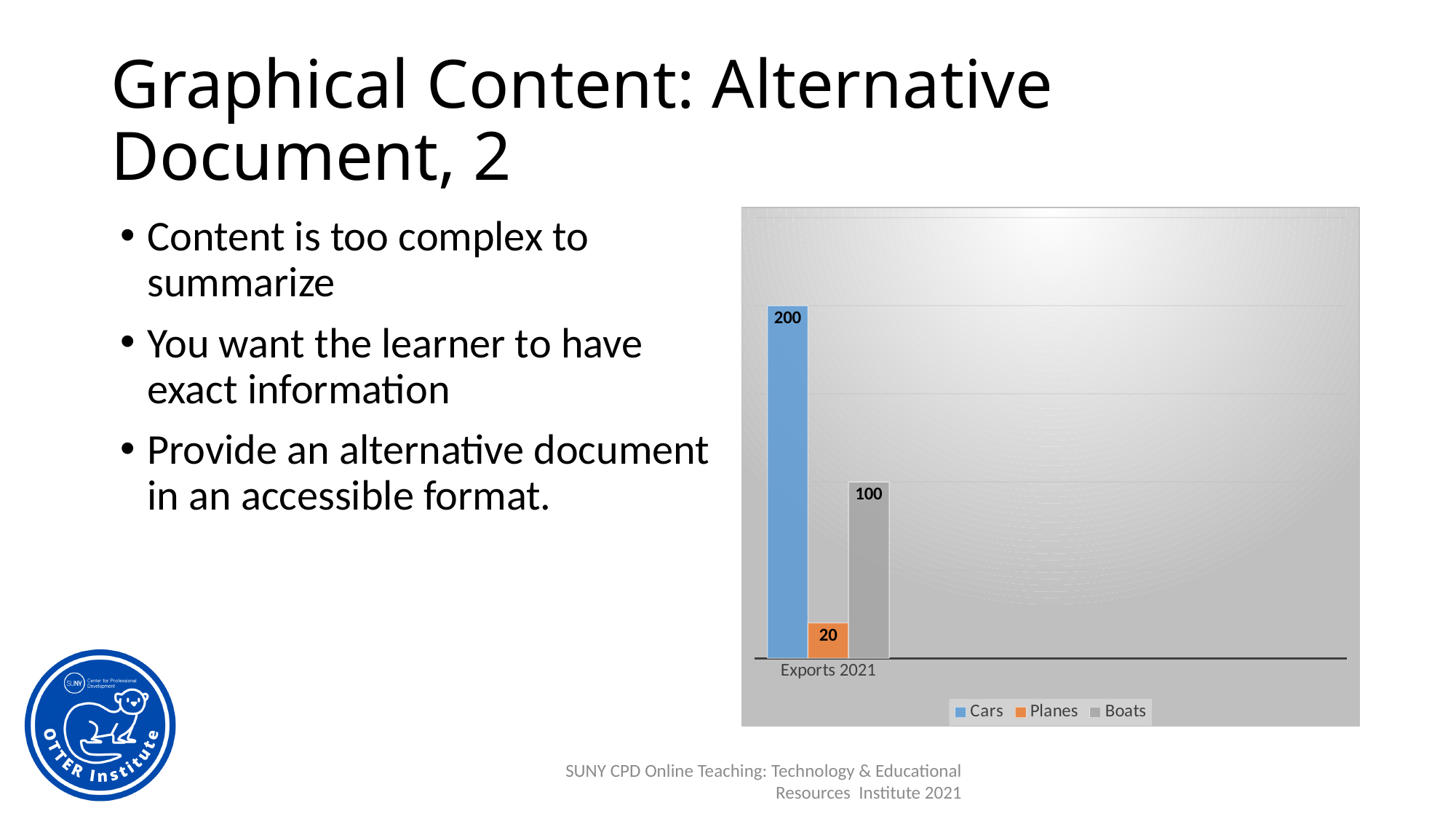
Which series has the lowest value in Exports 2021? Planes What kind of chart is shown on the slide? Bar chart What is the value for Boats in Exports 2021? 100 What colour is the Planes bar? Orange What is the difference between the Boats value and the Planes value? 80 What is the value for Cars in Exports 2021? 200 What is the difference between the Cars value and the Boats value? 100 How many categories are shown on the x axis? 1 What is the value for Planes in Exports 2021? 20 How many series does the legend list? 3 Which is larger, the value for Planes or the value for Boats? Boats Which series has the highest value in Exports 2021? Cars